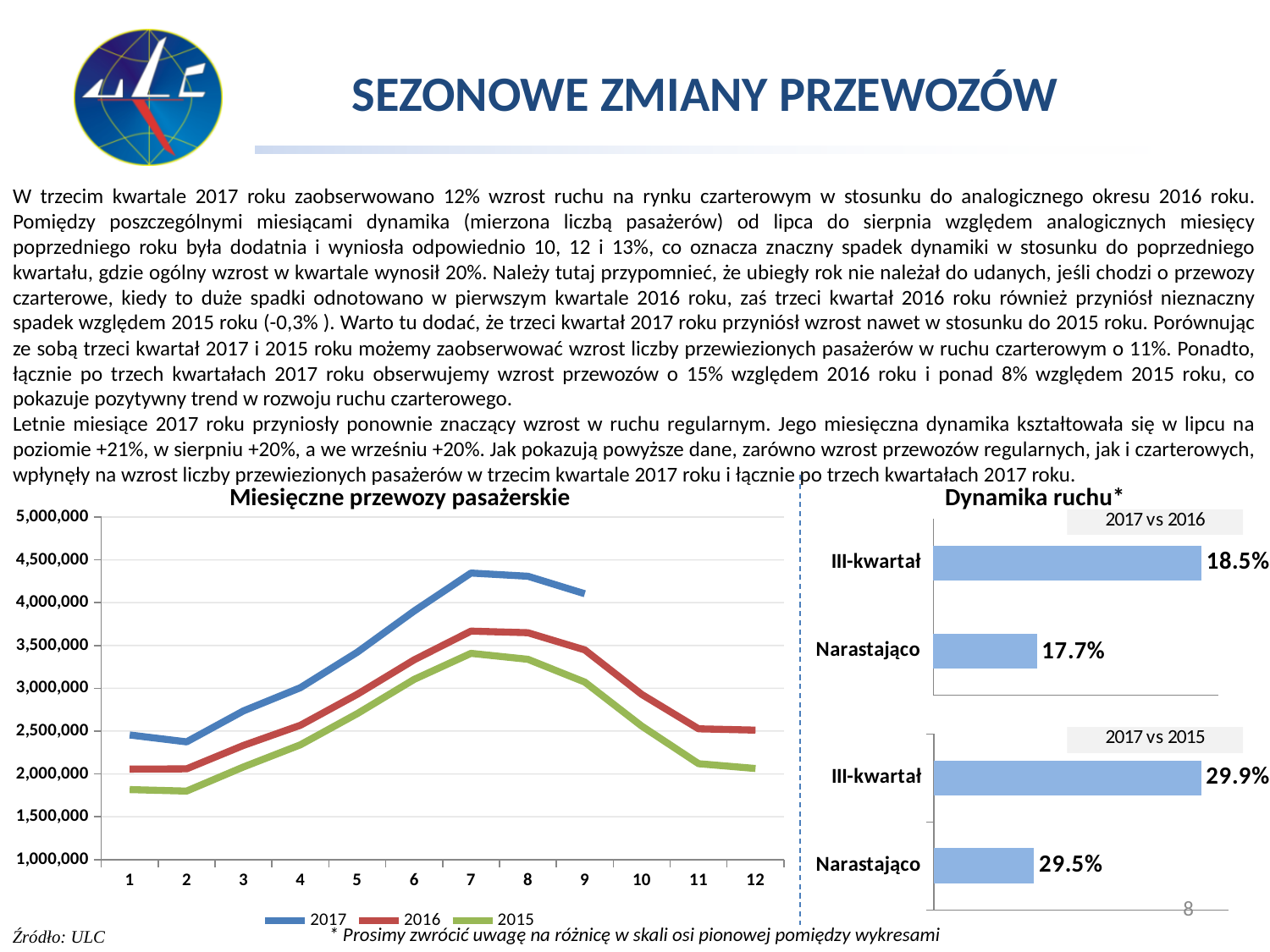
In the chart 'Miesięczne przewozy pasażerskie', is the 2015 value for month 1 greater or less than 2,000,000? less In the 'Dynamika ruchu' chart for 2017 vs 2016, what is the value for Narastająco? 17.7% In the chart 'Miesięczne przewozy pasażerskie', do the 2016 values rise or fall from month 7 to month 12? fall In the 'Dynamika ruchu' chart for 2017 vs 2015, what is the difference between III-kwartał and Narastająco? 0.4 percentage points In the 'Dynamika ruchu' charts, which is larger: III-kwartał for 2017 vs 2016 or III-kwartał for 2017 vs 2015? 2017 vs 2015 (29.9%) In the 'Dynamika ruchu' chart for 2017 vs 2016, what is the value for III-kwartał? 18.5% In the 'Dynamika ruchu' chart for 2017 vs 2015, what is the value for III-kwartał? 29.9% In the chart 'Miesięczne przewozy pasażerskie', how many series does the legend list? 3 In the chart 'Miesięczne przewozy pasażerskie', how many months does the 2017 series cover? 9 What kind of chart is 'Miesięczne przewozy pasażerskie'? line chart In the chart 'Miesięczne przewozy pasażerskie', which series has the highest value in month 7? 2017 In the chart 'Miesięczne przewozy pasażerskie', is the 2017 value for month 7 greater or less than 4,000,000? greater